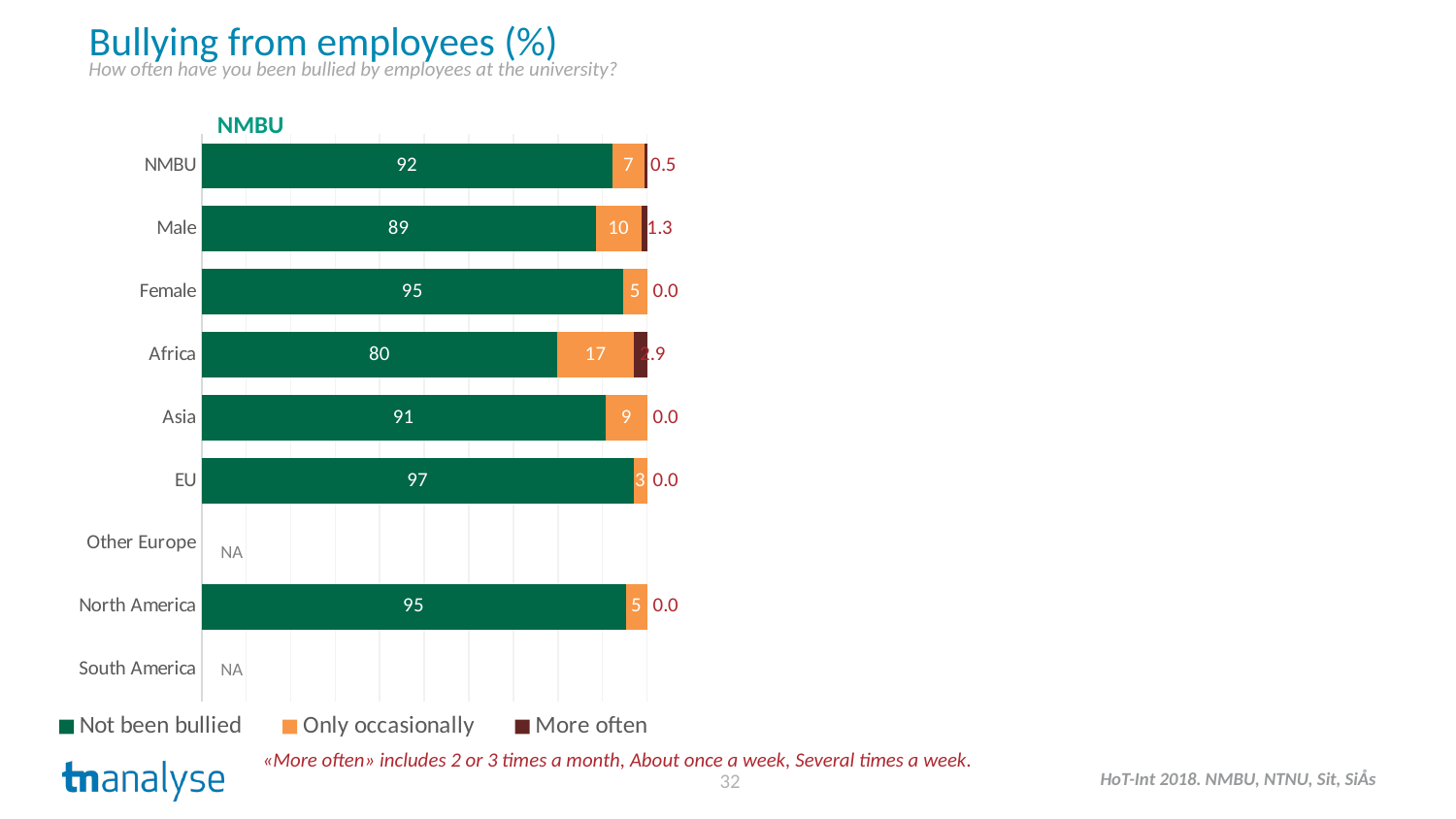
What is the 'Only occasionally' value for Africa? 17 How many categories are listed on the vertical axis of the chart? 9 What kind of chart is shown on the slide? Stacked bar chart Which categories are shown as NA in the chart? Other Europe and South America What is the 'More often' value for Male respondents? 1.3 What is the difference between the 'Not been bullied' values for EU and Africa? 17 What is the total of the stacked bar for Female? 100 Which category has the highest 'Not been bullied' value? EU How many series does the legend list? 3 Among the categories with data, which has the lowest 'Not been bullied' value? Africa Which has a larger 'Only occasionally' value, Male or Female? Male What percentage of NMBU respondents overall reported they had not been bullied by employees? 92